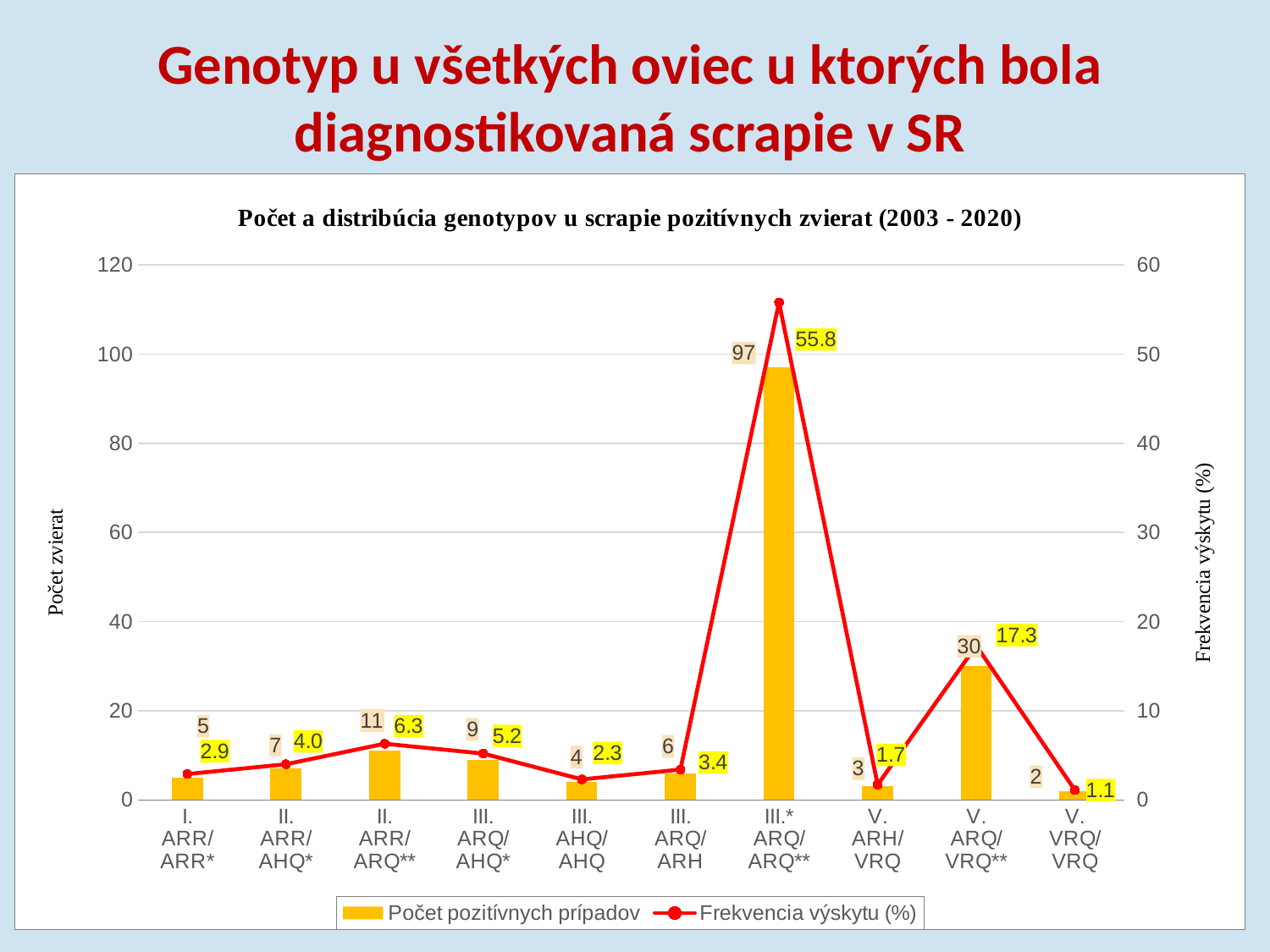
Which genotype has the lowest frequency of occurrence (%)? V. VRQ/VRQ What is the number of positive cases for genotype II. ARR/ARQ**? 11 How many series does the legend list? 2 What is the title of the chart? Počet a distribúcia genotypov u scrapie pozitívnych zvierat (2003 - 2020) What is the frequency of occurrence (Frekvencia výskytu (%)) for genotype V. ARQ/VRQ**? 17.3 Which genotype has the highest number of positive cases? III.* ARQ/ARQ** What is the difference in the number of positive cases between III.* ARQ/ARQ** and V. ARQ/VRQ**? 67 How many genotype categories are shown on the x axis? 10 What is the number of positive cases (Počet pozitívnych prípadov) for genotype III.* ARQ/ARQ**? 97 What kind of chart is used to show the number of positive cases? bar chart Is the number of positive cases for V. ARQ/VRQ** greater or less than 40? less Which has more positive cases: II. ARR/AHQ* or III. ARQ/AHQ*? III. ARQ/AHQ*